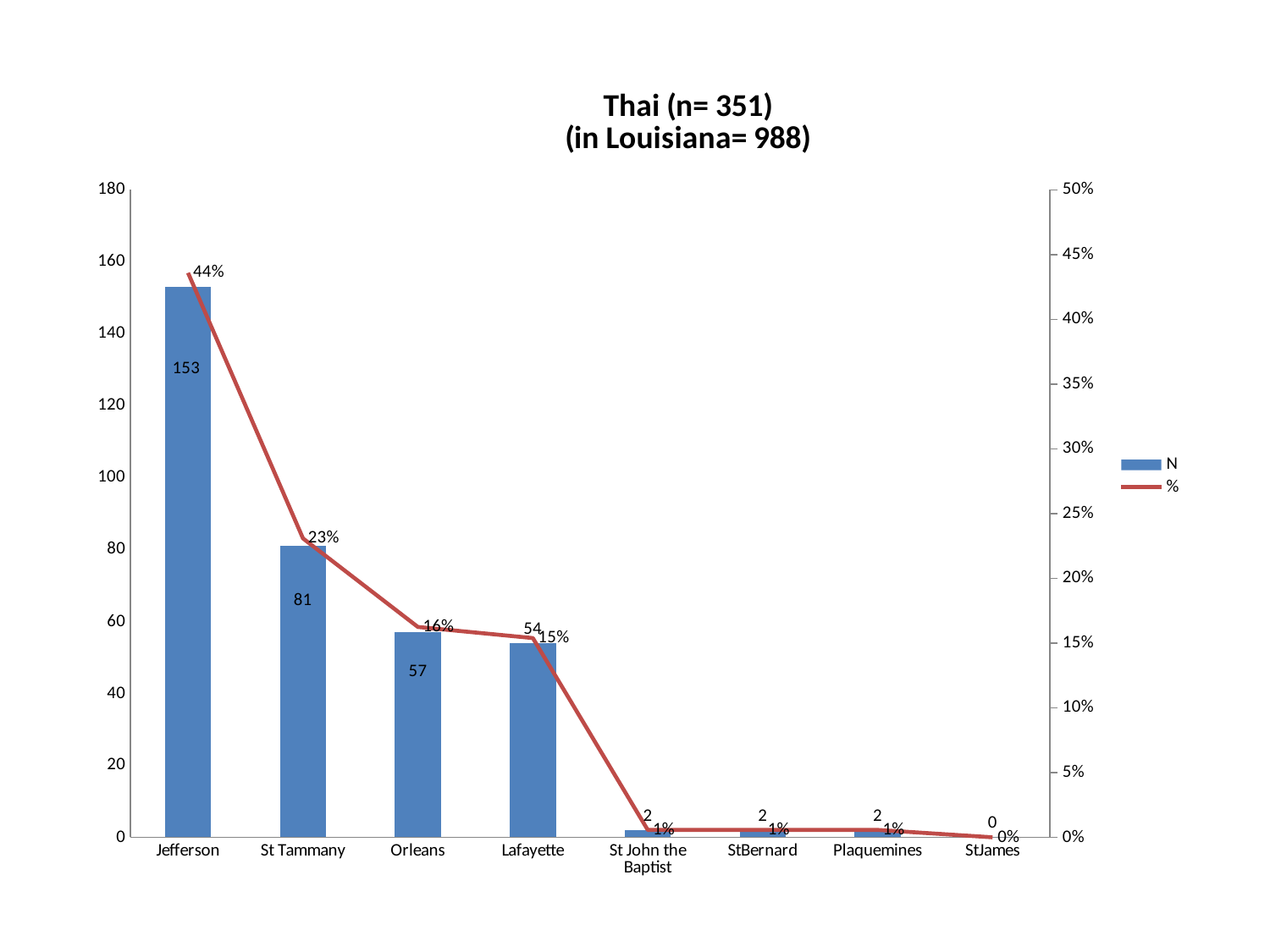
What is the N value for St Tammany? 81 What is the difference in N between Jefferson and St Tammany? 72 How many parishes are shown on the x axis? 8 How many series does the legend list? 2 Which has a larger N value, Orleans or Lafayette? Orleans What kind of chart is this? Combined bar and line chart What is the N value for Jefferson? 153 What is the title of the chart? Thai (n= 351) (in Louisiana= 988) Which parish has the highest N value? Jefferson What percentage is shown for Orleans? 16% What is the N value for Lafayette? 54 Which parish has the lowest N value? StJames